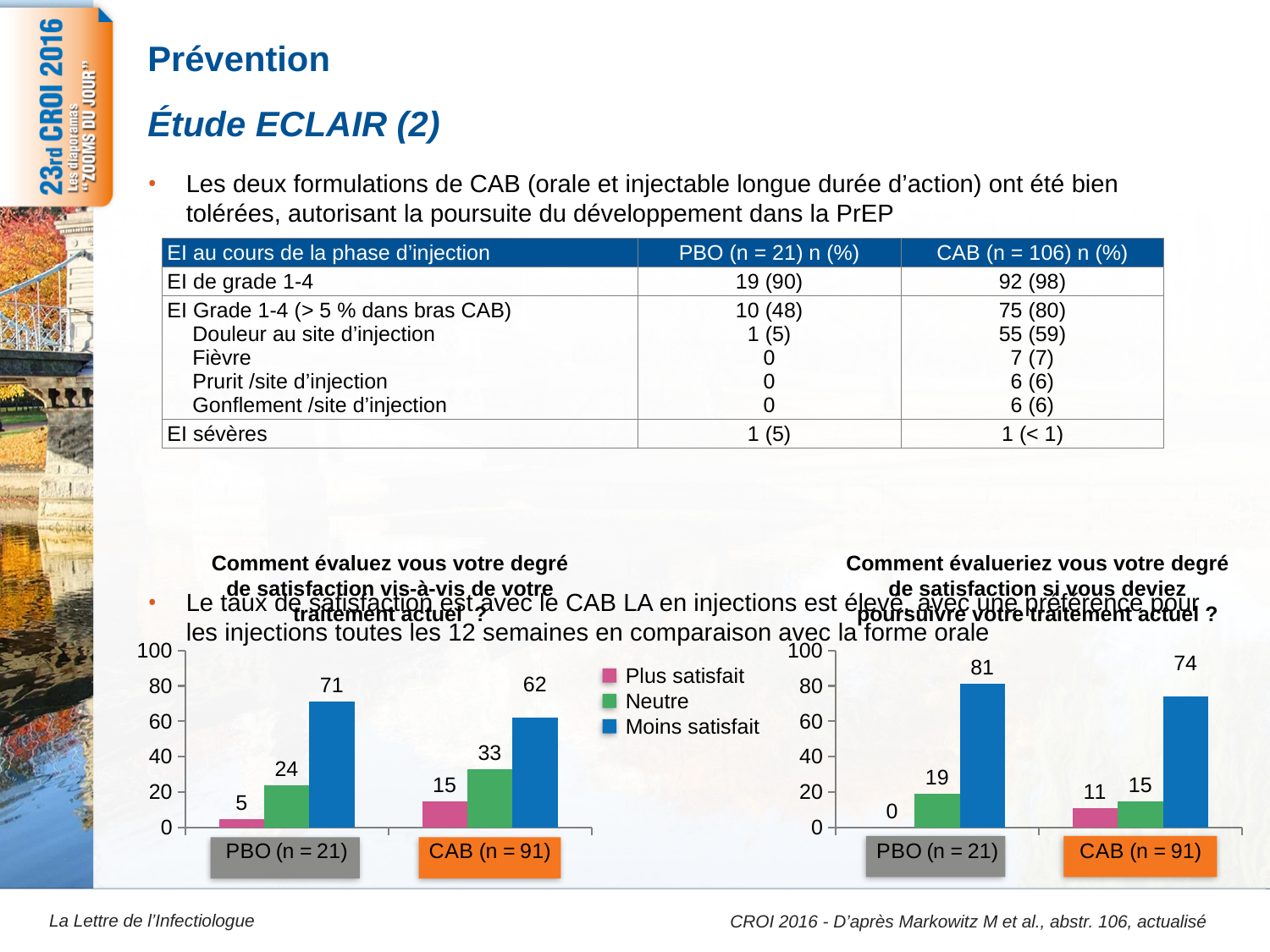
In the right chart, what is the value of the Plus satisfait series for CAB (n = 91)? 11 In the left chart, what is the value of the Neutre series for PBO (n = 21)? 24 In the legend of the satisfaction charts, which series is shown in green? Neutre In the left chart, which series has the highest value for CAB (n = 91)? Moins satisfait In the right chart, what is the value of the Moins satisfait series for PBO (n = 21)? 81 In the right chart, which series has the lowest value for PBO (n = 21)? Plus satisfait In the left chart, what is the difference between the Moins satisfait values for PBO (n = 21) and CAB (n = 91)? 9 How many series does the legend list for the satisfaction charts? 3 In the right chart, which is larger: the Neutre value for PBO (n = 21) or the Neutre value for CAB (n = 91)? PBO (n = 21) How many categories are shown on the x axis of the right chart? 2 In the left chart, what is the value of the Moins satisfait series for CAB (n = 91)? 62 What type of chart is the left chart? Bar chart